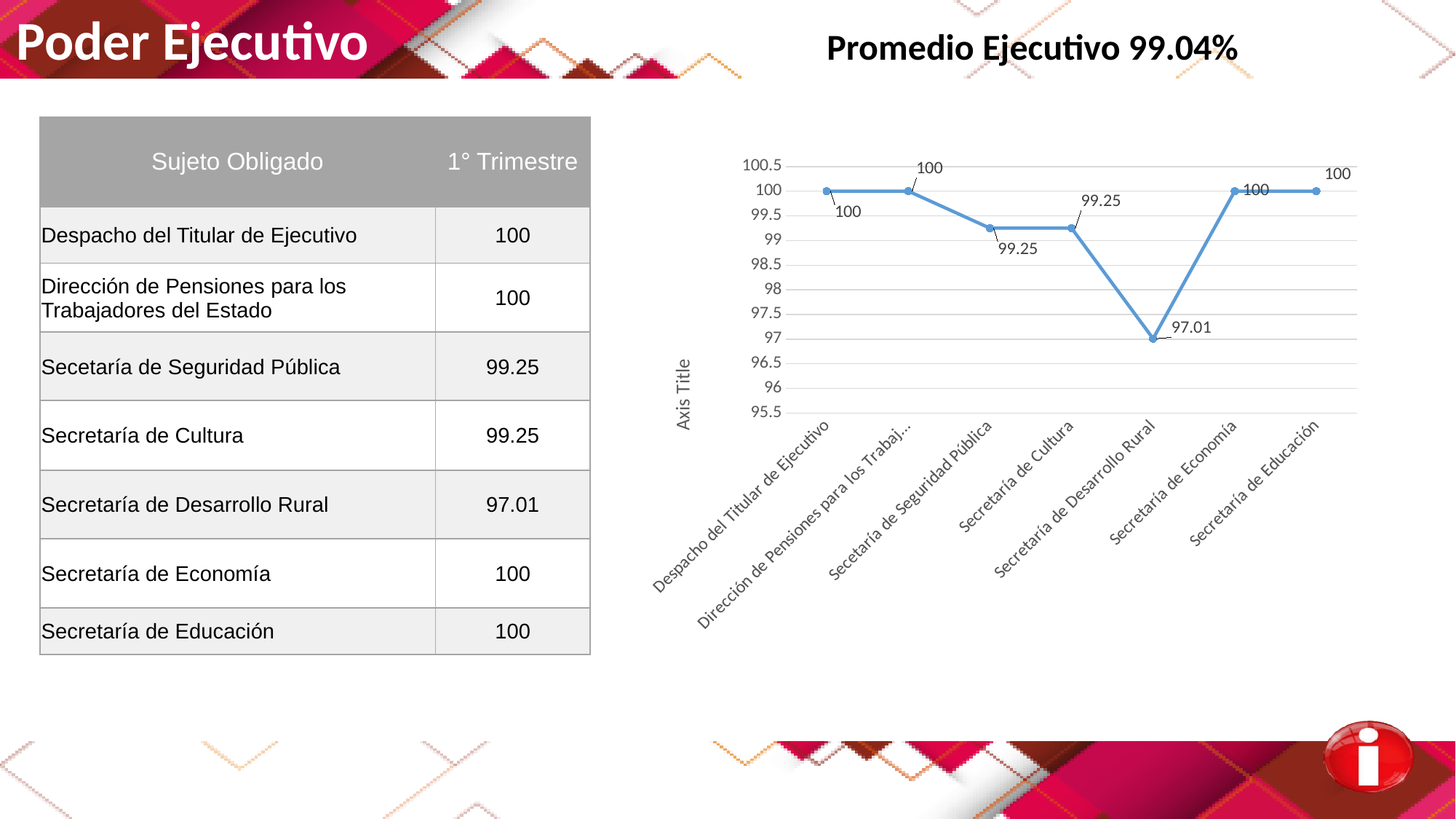
Is the value for Secretaría de Desarrollo Rural greater or less than 98? less Does the line rise or fall between Secretaría de Desarrollo Rural and Secretaría de Economía? rise What is the value for Secretaría de Economía in the chart? 100 What is the label shown on the vertical axis of the chart? Axis Title Which category has the lowest value in the chart? Secretaría de Desarrollo Rural Which is larger, the value for Secretaría de Cultura or the value for Secretaría de Desarrollo Rural? Secretaría de Cultura What is the value for Secretaría de Cultura in the chart? 99.25 What type of chart is shown on the slide? line chart What is the difference between the value for Despacho del Titular de Ejecutivo and the value for Secetaría de Seguridad Pública? 0.75 What is the difference between the value for Secretaría de Economía and the value for Secretaría de Desarrollo Rural? 2.99 How many categories are plotted on the x axis of the chart? 7 What is the value for Secretaría de Desarrollo Rural in the chart? 97.01